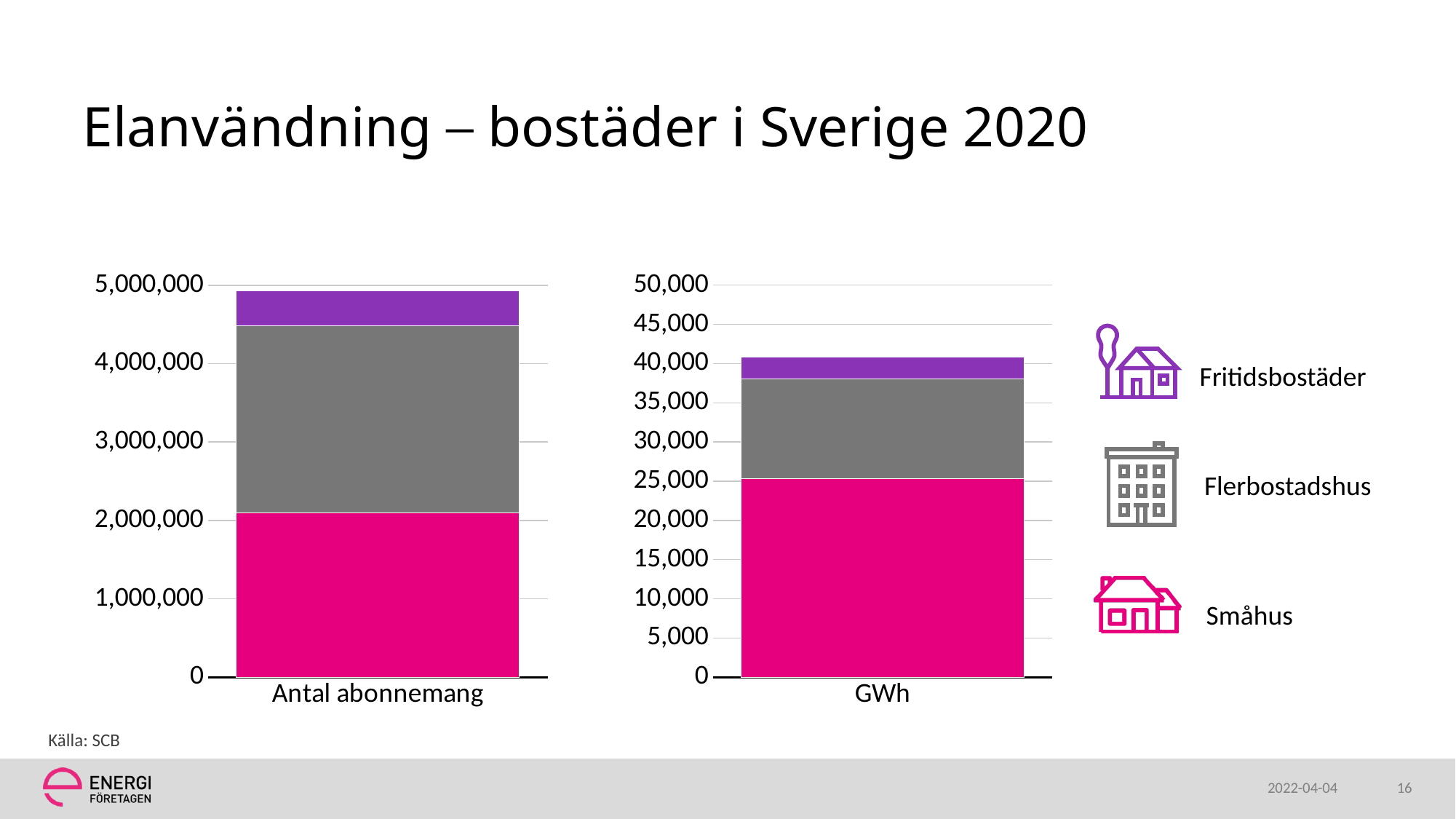
In the 'GWh' chart, which series has the smallest segment? Fritidsbostäder How many series does the legend list for the charts? 3 In the 'GWh' chart, which series has the largest segment? Småhus In the 'Antal abonnemang' chart, is the Småhus segment greater or less than 2,000,000? greater How many categories are shown on the x axis of the right chart labelled 'GWh'? 1 What kind of chart is the left chart labelled 'Antal abonnemang'? stacked bar chart In the 'GWh' chart, is the Småhus segment greater or less than 20,000? greater In the 'GWh' chart, is the total height of the stacked bar greater or less than 40,000? greater In the 'GWh' chart, which segment is larger: Småhus or Flerbostadshus? Småhus In the 'Antal abonnemang' chart, which series has the smallest segment? Fritidsbostäder Which colour represents Flerbostadshus in the charts? grey